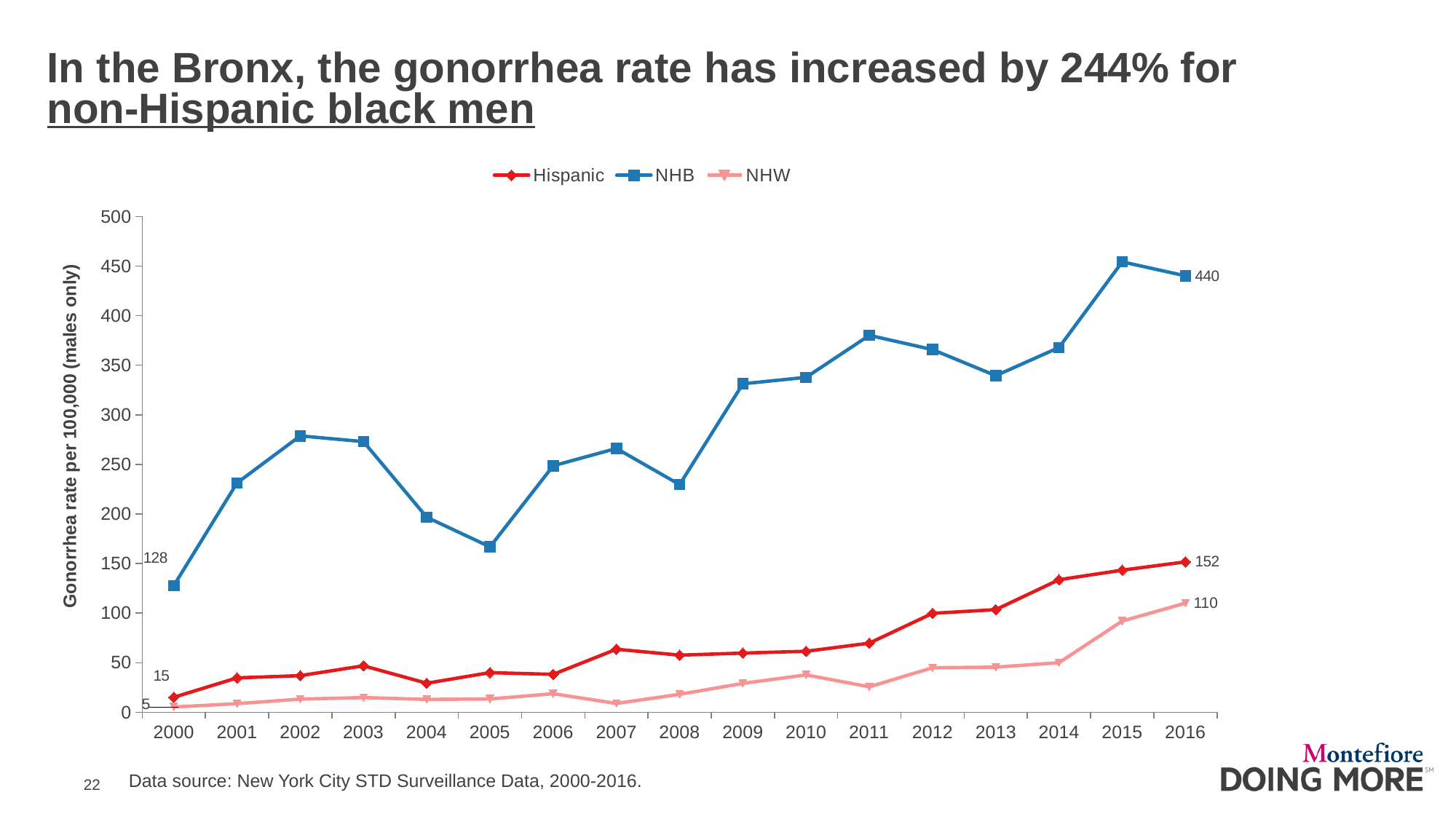
What is the difference between the Hispanic and NHW rates in 2016? 42 What kind of chart is shown on the slide? Line chart In which year is the NHB rate lowest? 2000 What is the NHW gonorrhea rate in 2000? 5 By how much did the NHB rate increase from 2000 to 2016? 312 How many series does the legend list? 3 What is the NHB gonorrhea rate in 2000? 128 Is the NHB value for 2015 greater or less than 400? greater What is the NHB gonorrhea rate in 2016? 440 In 2016, which group has the higher rate, NHB or Hispanic? NHB What is the Hispanic gonorrhea rate in 2016? 152 Is the NHB value for 2005 greater or less than 200? less